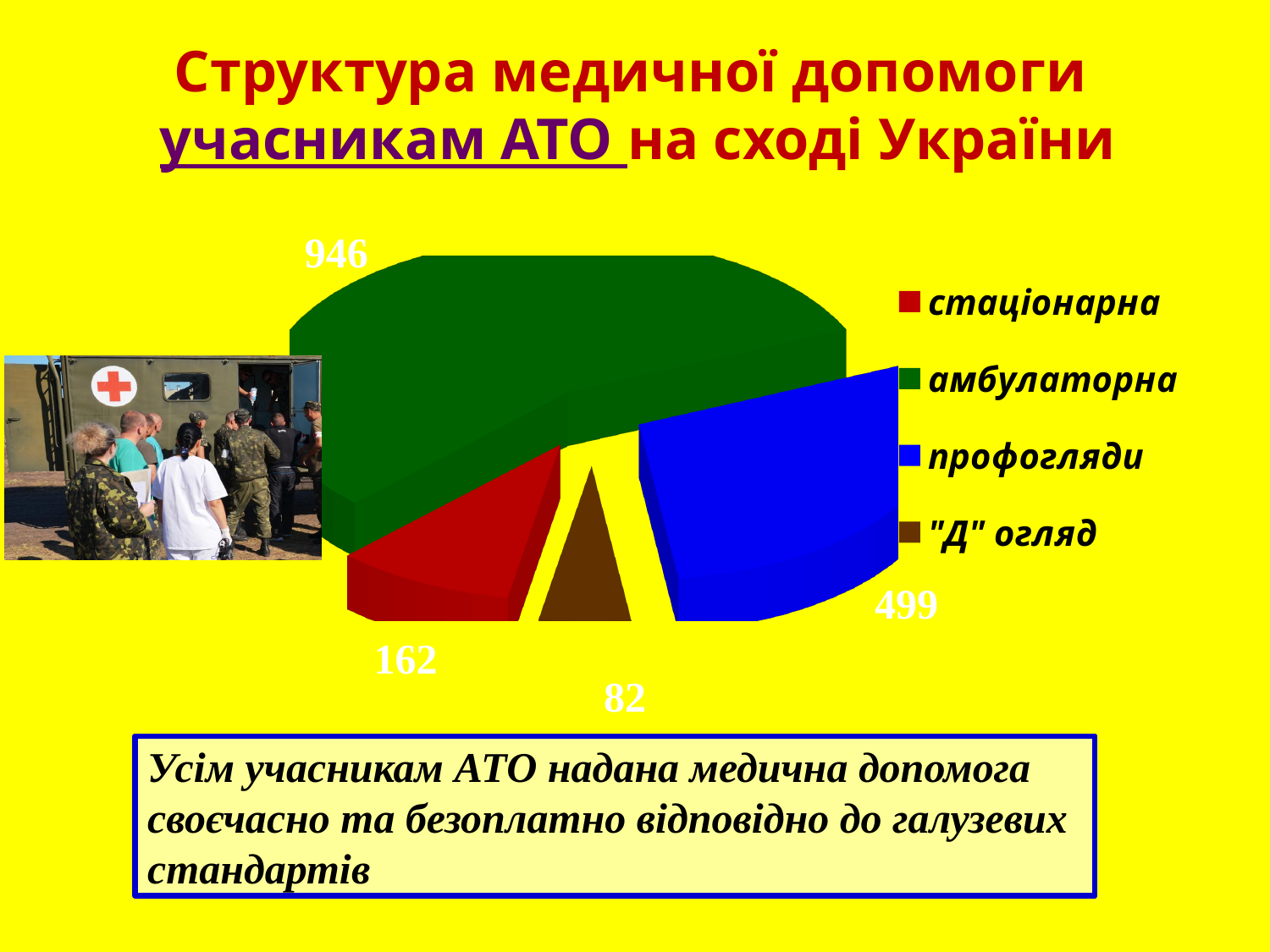
What is the value for "Д" огляд? 82 What colour is the slice for профогляди? blue What is the difference between the values for стаціонарна and "Д" огляд? 80 What type of chart is shown on the slide? pie chart What is the value for амбулаторна? 946 Which category has the largest slice of the pie? амбулаторна How many categories does the pie chart have? 4 What is the value for профогляди? 499 What is the difference between the values for амбулаторна and профогляди? 447 Which is larger, the value for профогляди or the value for стаціонарна? профогляди What is the value for стаціонарна? 162 Which category has the smallest slice of the pie? "Д" огляд